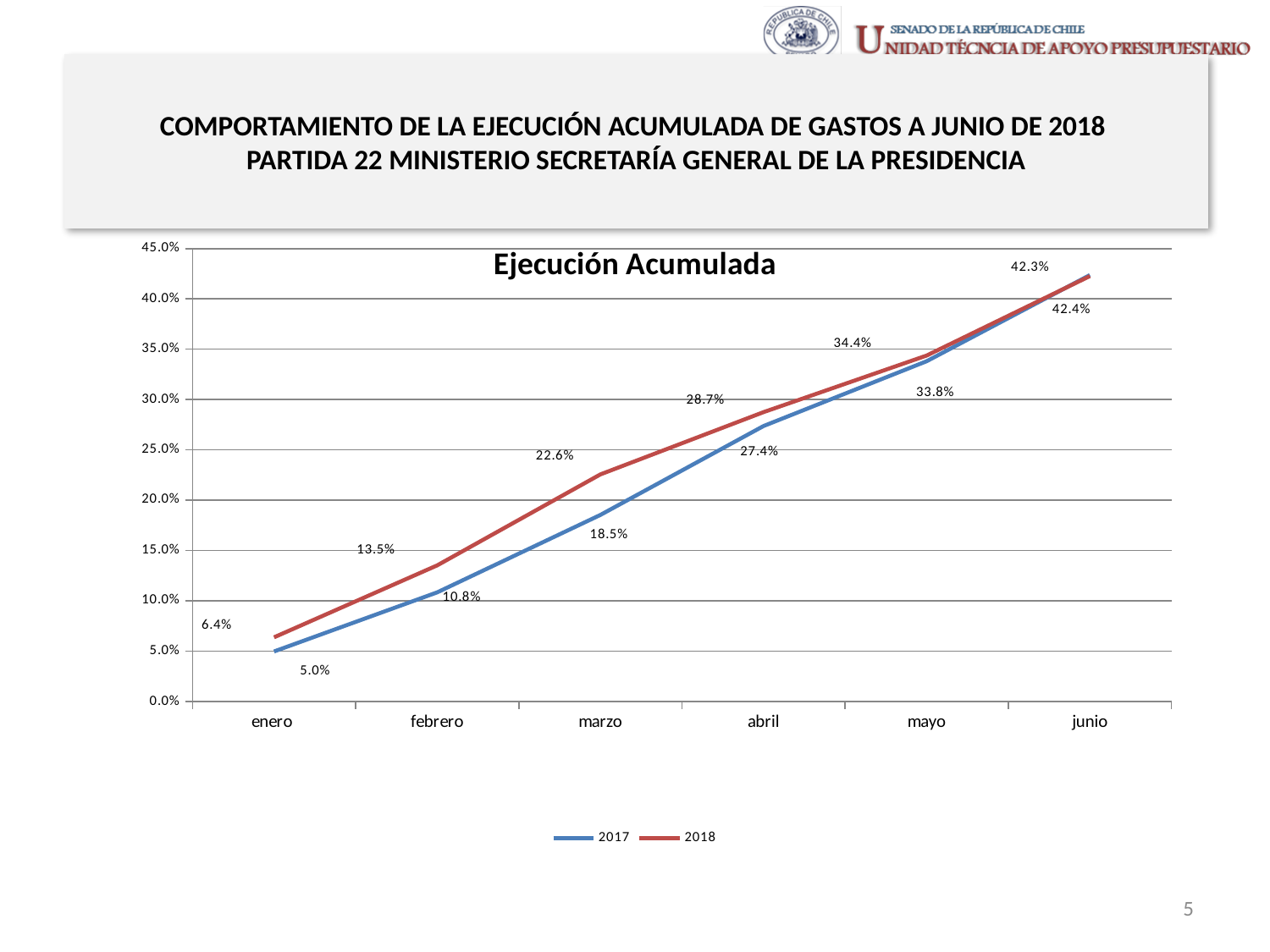
What is the title of the chart? Ejecución Acumulada What is the value for 2018 in marzo? 22.6% What is the value for 2017 in enero? 5.0% How many months are shown on the x axis? 6 In which month is the 2018 value highest? junio Which series has the larger value in febrero, 2017 or 2018? 2018 How many series does the legend list? 2 What is the difference between the 2018 and 2017 values in marzo? 4.1% In which month is the 2017 value lowest? enero What type of chart is shown on the slide? line chart What is the value for 2017 in mayo? 33.8% What is the value for 2018 in abril? 28.7%